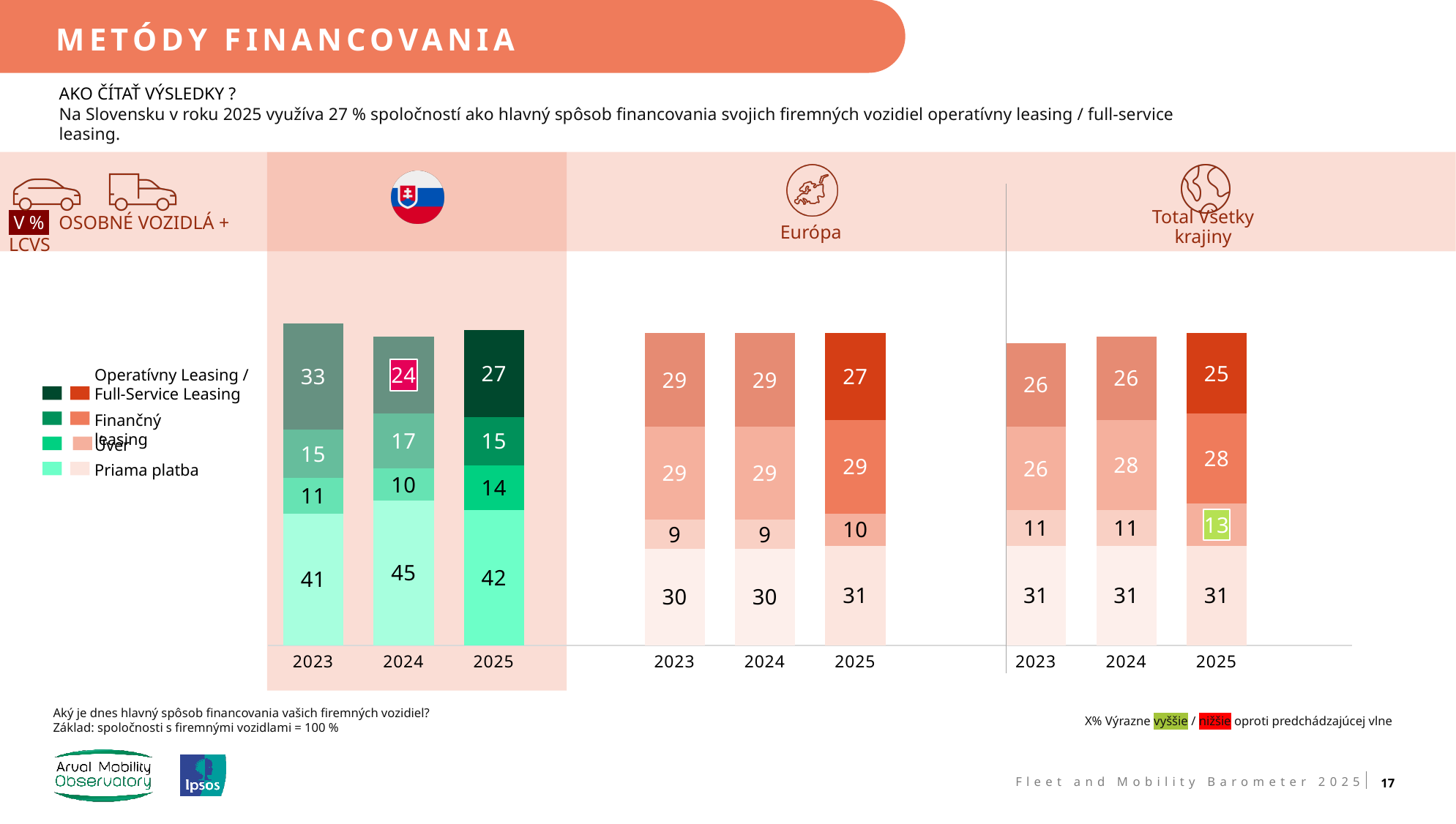
How many years (bars) are shown in the Európa chart? 3 In the left chart (Slovakia, with the flag), which year has the highest value for Operatívny Leasing / Full-Service Leasing? 2023 How many series does the legend list? 4 In the left chart (Slovakia, with the flag), what is the value for Priama platba in 2024? 45 In the Total všetky krajiny chart, which year has the lowest value for Operatívny Leasing / Full-Service Leasing? 2025 In the Total všetky krajiny chart, what is the value for Úver in 2025? 13 In the Európa chart, what is the difference between the Priama platba values for 2025 and 2023? 1 In the left chart (Slovakia, with the flag), what is the difference between the Operatívny Leasing / Full-Service Leasing values for 2023 and 2024? 9 In the Európa chart, what is the value for Operatívny Leasing / Full-Service Leasing in 2025? 27 In the left chart (Slovakia, with the flag), what is the value for Finančný leasing in 2024? 17 What kind of chart is used for the Total všetky krajiny data? stacked bar chart In the Total všetky krajiny chart, is the Finančný leasing value for 2024 larger or smaller than for 2023? larger